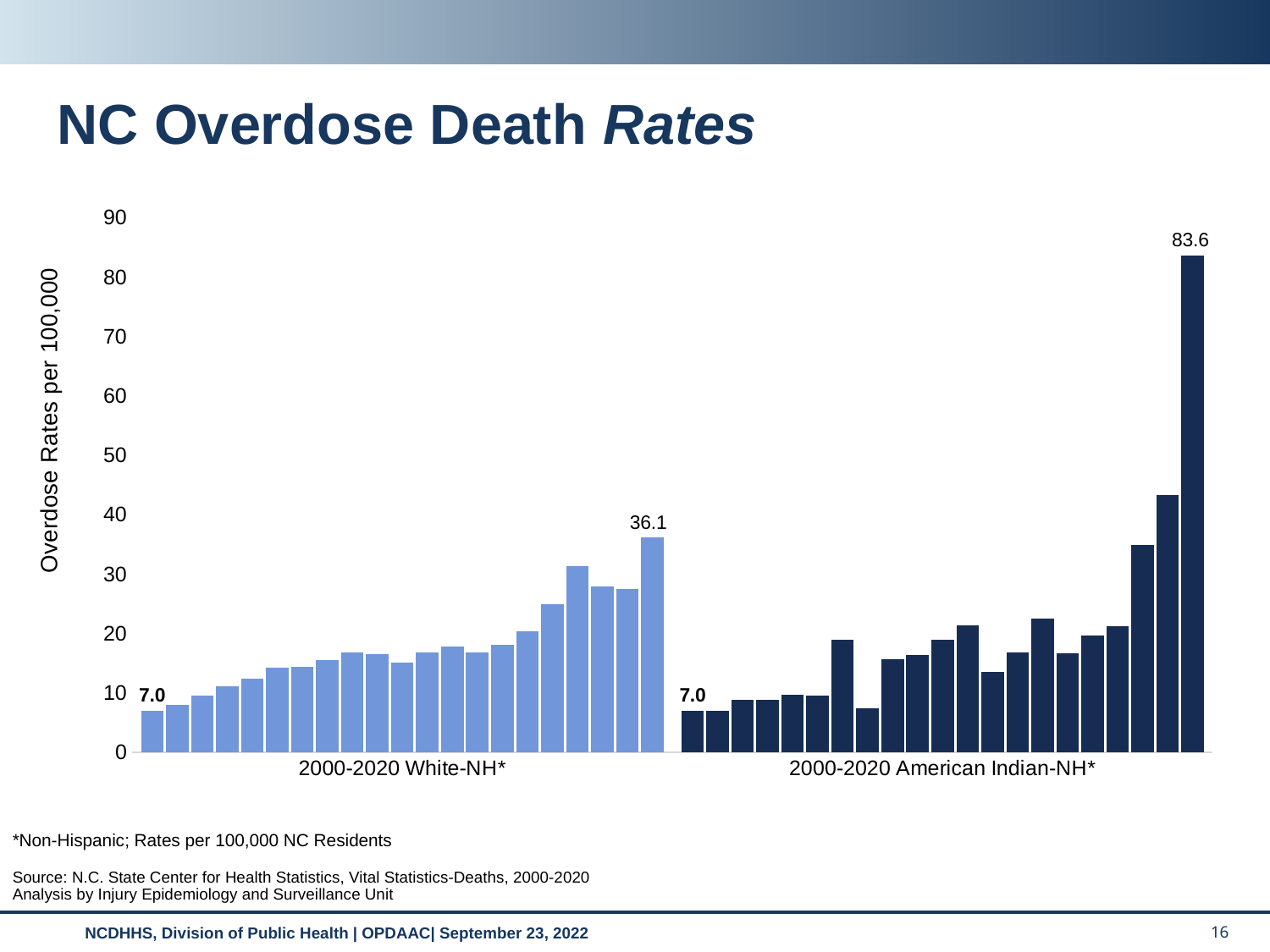
Is the 2020 overdose death rate for American Indian-NH greater or less than 80? greater What is the label on the vertical axis of the chart? Overdose Rates per 100,000 What is the difference between the 2020 American Indian-NH rate (83.6) and the 2020 White-NH rate (36.1)? 47.5 By how much did the White-NH overdose death rate increase from 2000 (7.0) to 2020 (36.1)? 29.1 Which group has the higher overdose death rate in 2020, White-NH or American Indian-NH? American Indian-NH What kind of chart is shown on the slide? bar chart What is the overdose death rate labeled for the last bar (2020) in the White-NH group? 36.1 What is the overdose death rate labeled for the first bar (2000) in the White-NH group? 7.0 What is the highest overdose death rate shown on the chart? 83.6 What is the overdose death rate labeled for the first bar (2000) in the American Indian-NH group? 7.0 What is the overdose death rate labeled for the last bar (2020) in the American Indian-NH group? 83.6 Do the overdose death rates for the American Indian-NH group generally rise or fall from 2000 to 2020? rise